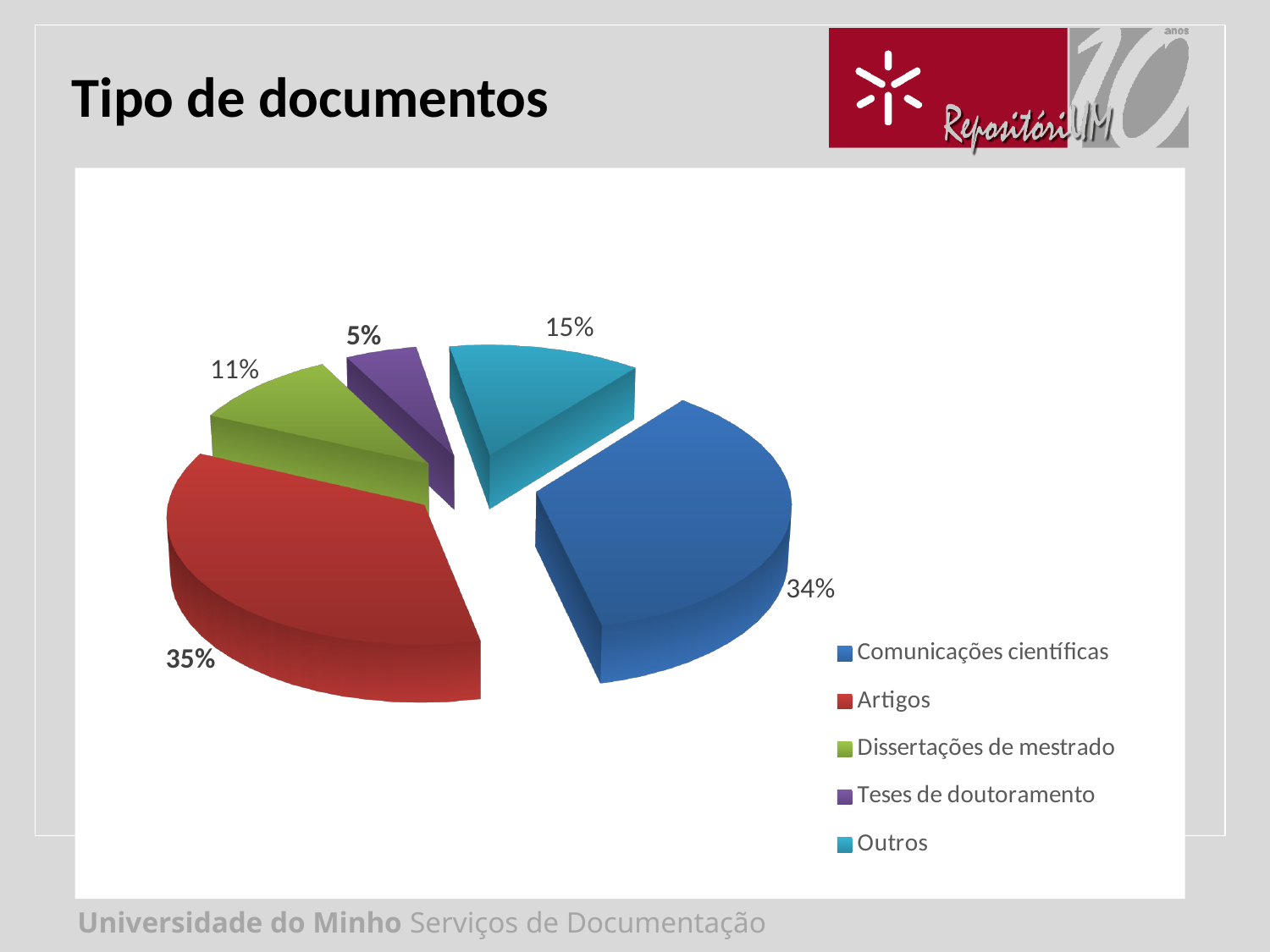
What percentage of the pie is Comunicações científicas? 34% How many categories does the pie chart have? 5 What type of chart is shown on the slide? pie chart What percentage of the pie is Artigos? 35% What is the difference in percentage points between Outros and Dissertações de mestrado? 4 What percentage of the pie is Teses de doutoramento? 5% What percentage of the pie is Dissertações de mestrado? 11% Which is larger, the share for Outros or the share for Teses de doutoramento? Outros What is the title of the slide containing the pie chart? Tipo de documentos What percentage of the pie is Outros? 15% Which category has the smallest share of the pie? Teses de doutoramento Which category has the largest share of the pie? Artigos